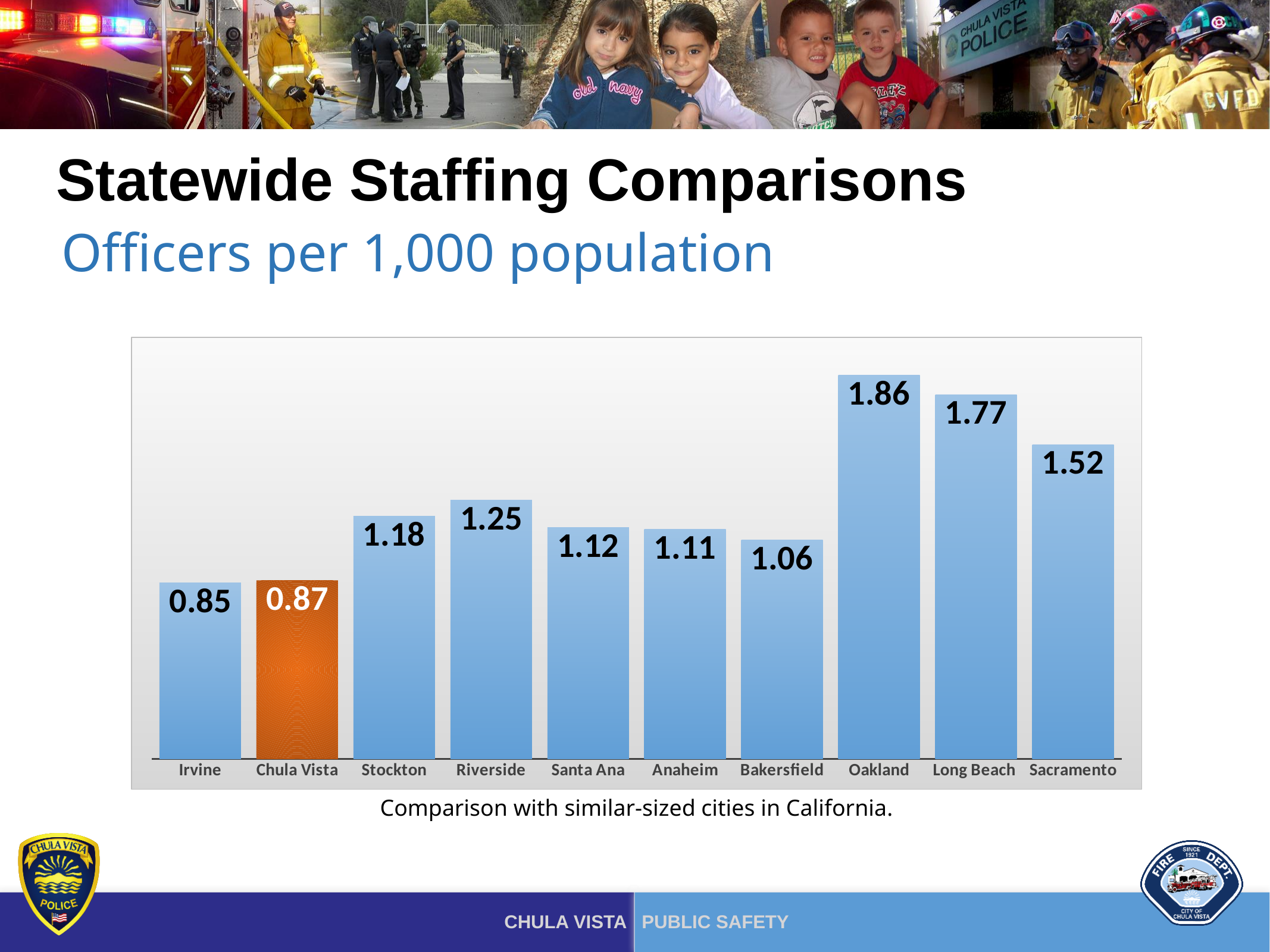
What kind of chart is shown on the slide? Bar chart What is the difference between the values for Long Beach and Sacramento? 0.25 Which city's bar is highlighted in orange? Chula Vista What is the value for Chula Vista? 0.87 Which city has the lowest officers per 1,000 population? Irvine Which has a higher value, Sacramento or Long Beach? Long Beach Which has a higher value, Riverside or Stockton? Riverside How many cities are shown in the chart? 10 What is the difference between the values for Oakland and Chula Vista? 0.99 What is the value for Oakland? 1.86 What is the value for Bakersfield? 1.06 Which city has the highest officers per 1,000 population? Oakland